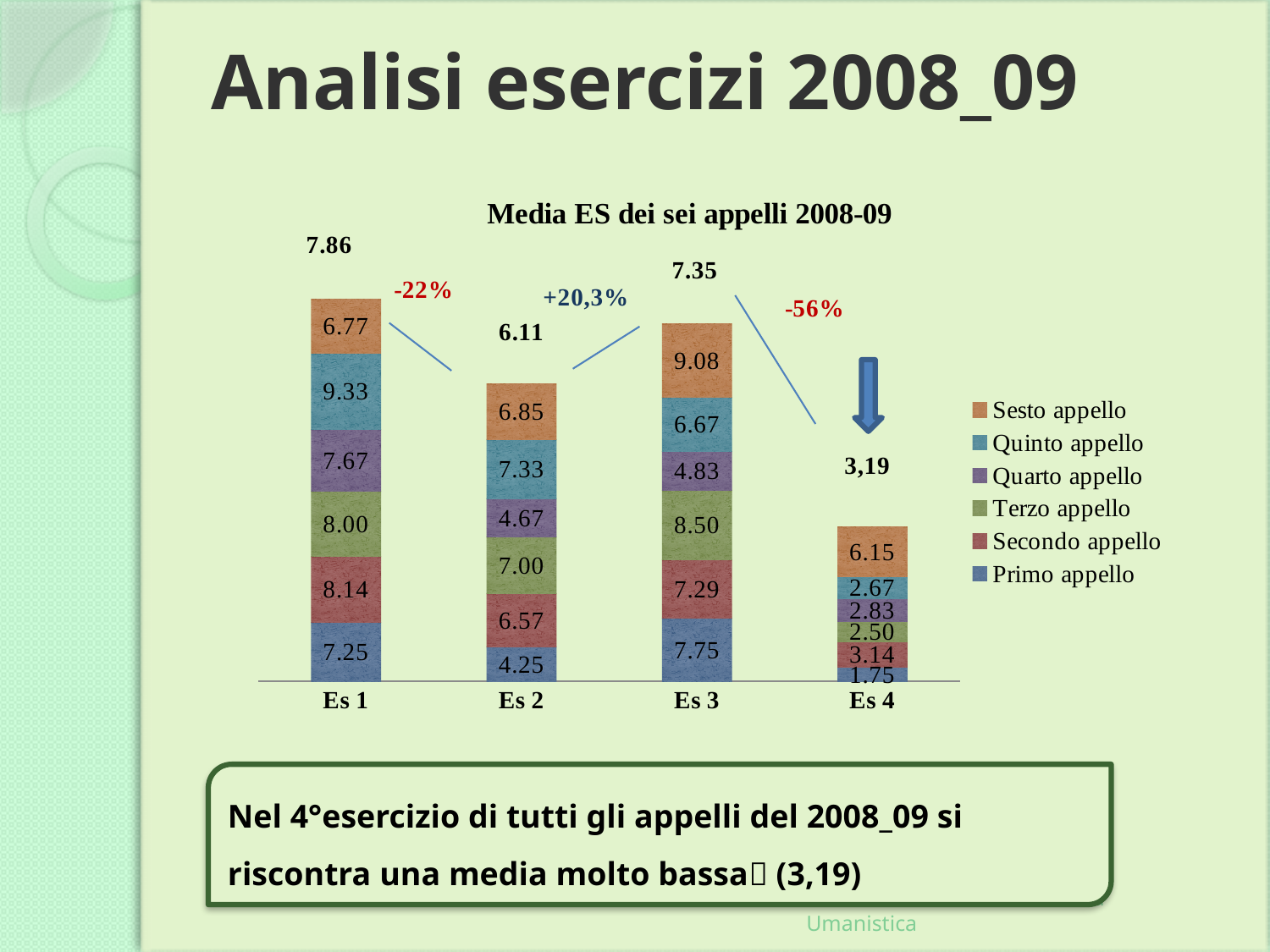
What is the difference between the Secondo appello values for Es 1 and Es 2? 1.57 Which is larger, the Quarto appello value for Es 1 or for Es 3? Es 1 What is the title of the chart? Media ES dei sei appelli 2008-09 What is the value of Primo appello for Es 1? 7.25 What is the value of Sesto appello for Es 3? 9.08 What type of chart is shown on the slide? Stacked bar chart What is the value of Quinto appello for Es 4? 2.67 How many categories are shown on the x axis? 4 How many series does the legend list? 6 Which category has the lowest value for Primo appello? Es 4 Which category has the highest value for Quinto appello? Es 1 What is the value of Terzo appello for Es 2? 7.00